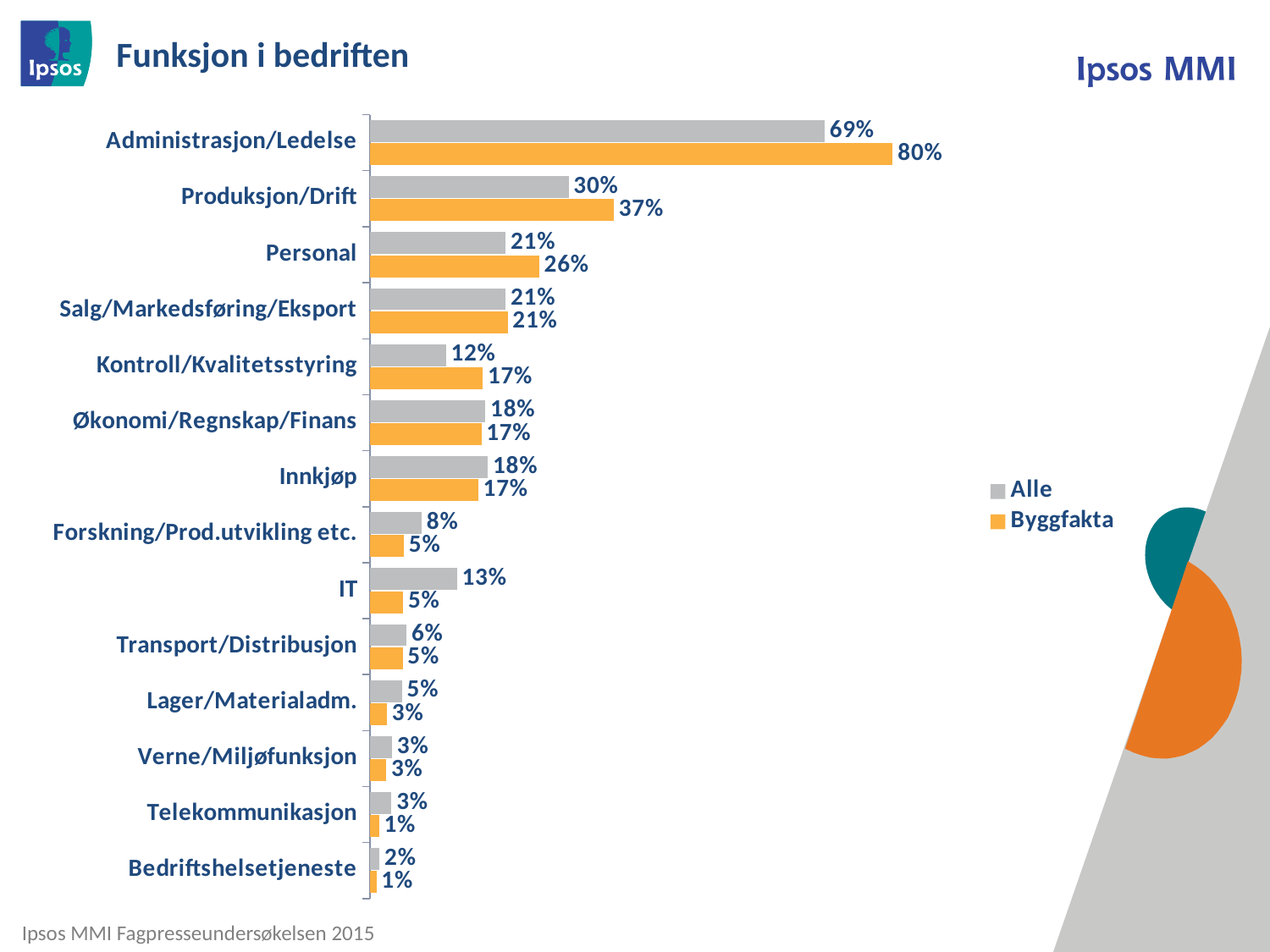
What is the difference between the Byggfakta and Alle values for Administrasjon/Ledelse? 11% What is the Byggfakta value for Personal? 26% How many series does the legend list? 2 What is the difference between the Alle and Byggfakta values for IT? 8% What kind of chart is shown on the slide? Bar chart What is the Alle value for IT? 13% What is the Alle value for Produksjon/Drift? 30% How many categories are shown on the chart? 14 Which is larger for Kontroll/Kvalitetsstyring, the Alle value or the Byggfakta value? Byggfakta Which category has the lowest Alle value? Bedriftshelsetjeneste Which category has the highest Alle value? Administrasjon/Ledelse What is the Byggfakta value for Administrasjon/Ledelse? 80%